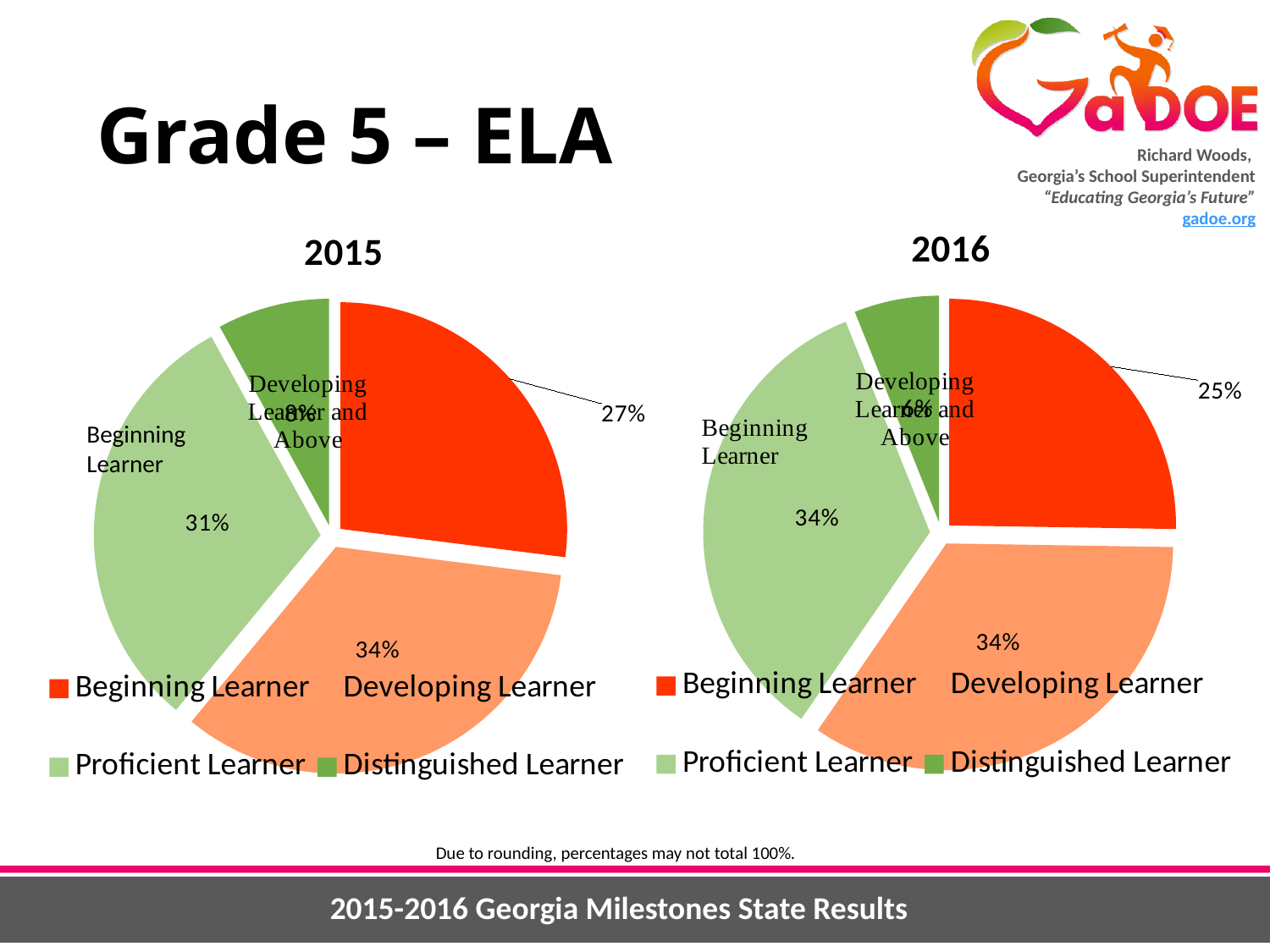
In the 2016 pie chart, what percentage is shown for Beginning Learner? 25% In the 2015 pie chart, what percentage is shown for Beginning Learner? 27% In the 2015 pie chart, what percentage is shown for Proficient Learner? 31% What is the difference between the Beginning Learner percentage in the 2015 chart and in the 2016 chart? 2% In the 2016 pie chart, which category has the smallest share? Distinguished Learner In the 2016 pie chart, what percentage is shown for Proficient Learner? 34% Which is larger in the 2015 pie chart: the Proficient Learner share or the Beginning Learner share? Proficient Learner In the 2015 pie chart, what percentage is shown for Developing Learner? 34% What type of chart is used for the 2016 data? Pie chart In the 2016 pie chart, what percentage is shown for Distinguished Learner? 6% In the 2015 pie chart, which category has the smallest share? Distinguished Learner In the 2015 pie chart, which category has the largest share? Developing Learner